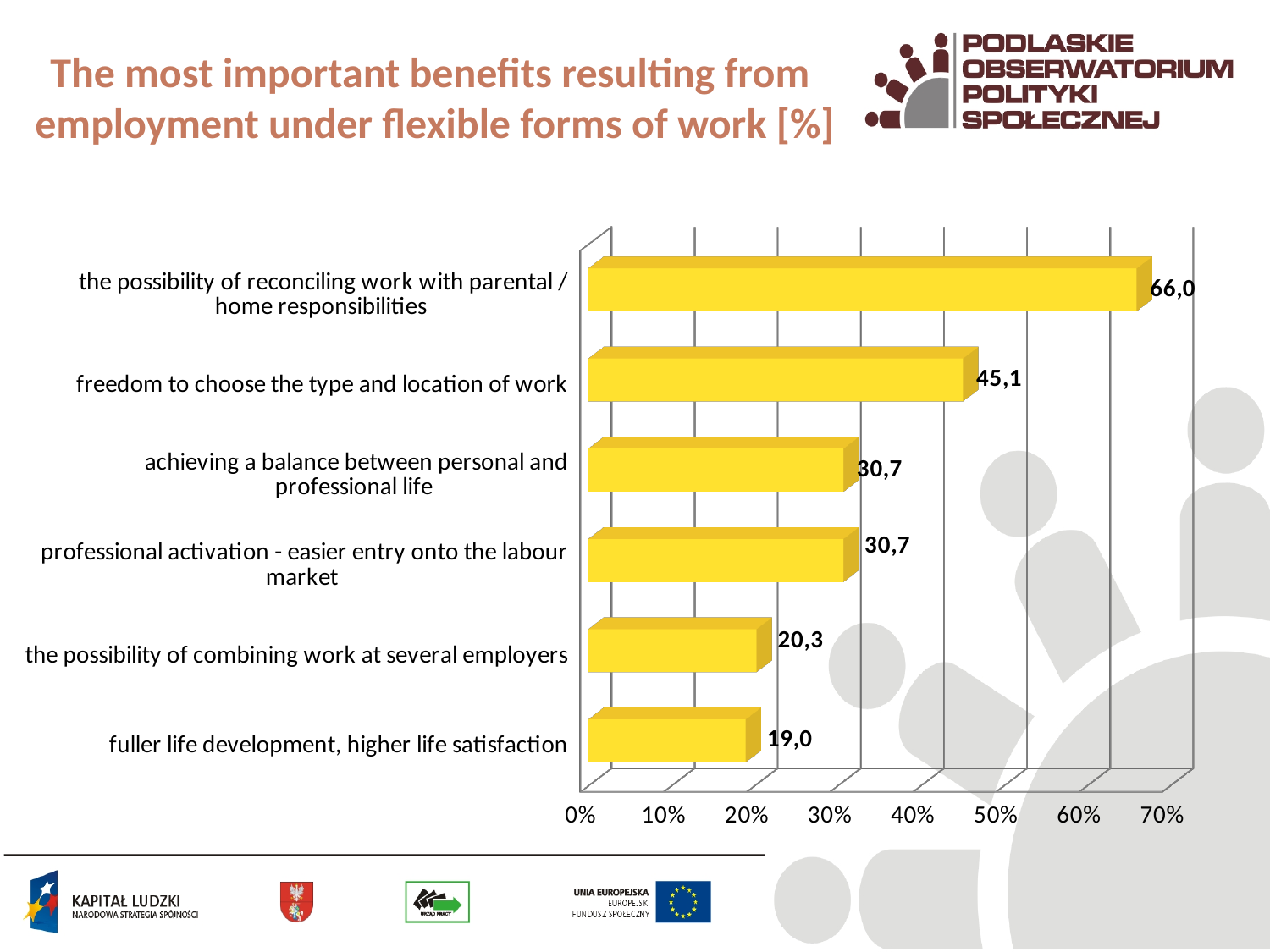
What is the title of the chart on the slide? The most important benefits resulting from employment under flexible forms of work [%] What is the value for 'fuller life development, higher life satisfaction'? 19,0 What is the value for 'the possibility of combining work at several employers'? 20,3 What is the value for 'freedom to choose the type and location of work'? 45,1 Is the value for 'the possibility of reconciling work with parental / home responsibilities' greater or less than 60%? greater Which category has the highest value? the possibility of reconciling work with parental / home responsibilities How many categories are shown in the chart? 6 What is the difference between the values for 'the possibility of reconciling work with parental / home responsibilities' and 'freedom to choose the type and location of work'? 20,9 What is the value for 'professional activation - easier entry onto the labour market'? 30,7 Which category has the lowest value? fuller life development, higher life satisfaction What kind of chart is shown on the slide? bar chart Which is larger: the value for 'freedom to choose the type and location of work' or 'achieving a balance between personal and professional life'? freedom to choose the type and location of work